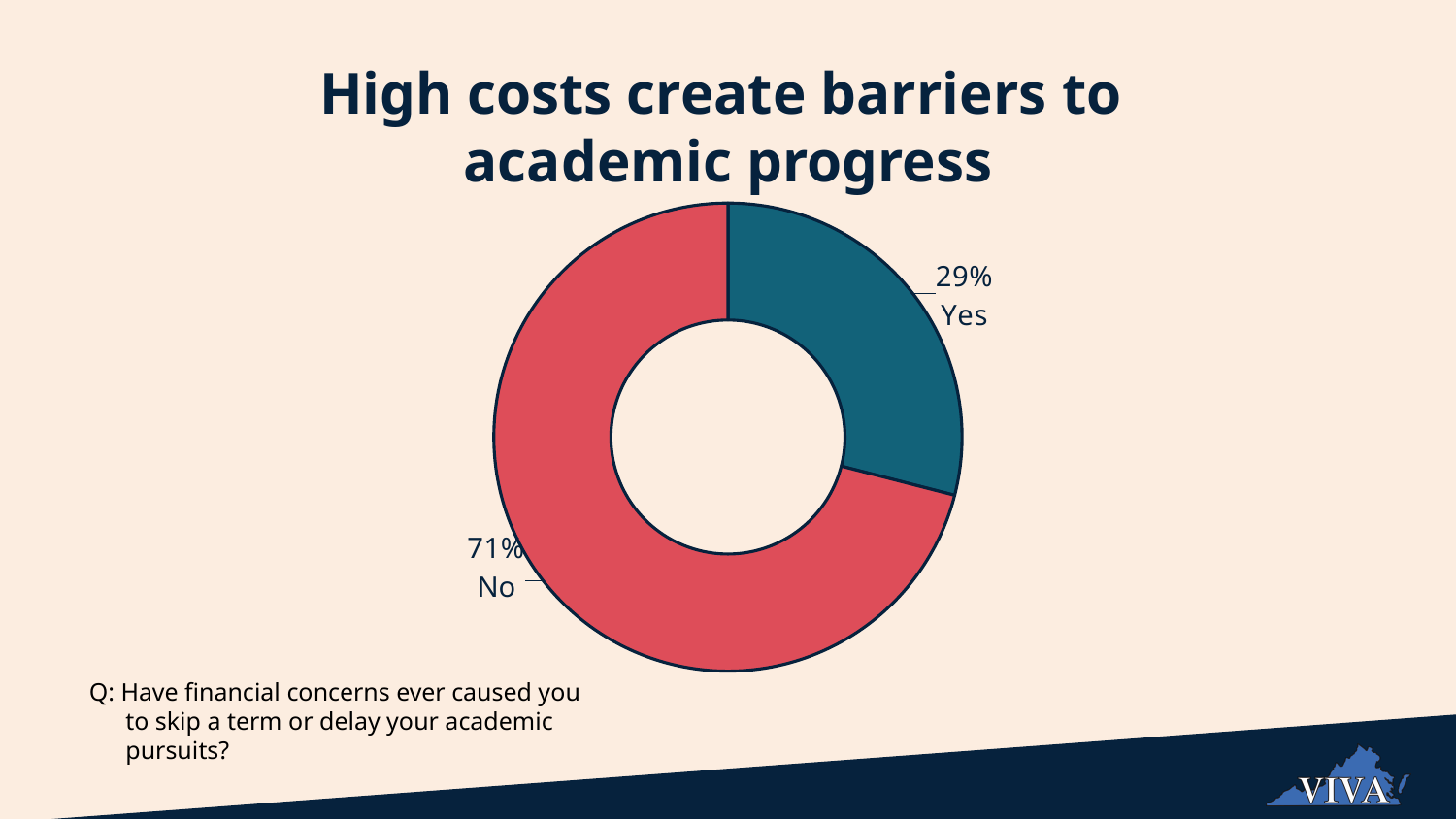
Which response has the larger share of the chart? No What is the difference in percentage points between the No and Yes shares? 42 What kind of chart is shown on the slide? pie chart (donut) What percentage of respondents answered Yes? 29% Which response has the smaller share of the chart? Yes What is the title of the slide? High costs create barriers to academic progress What colour is the Yes slice? teal What percentage of respondents answered No? 71% How many slices does the chart have? 2 Is the share for Yes larger or smaller than the share for No? smaller What share of the chart does the No slice represent? 71%